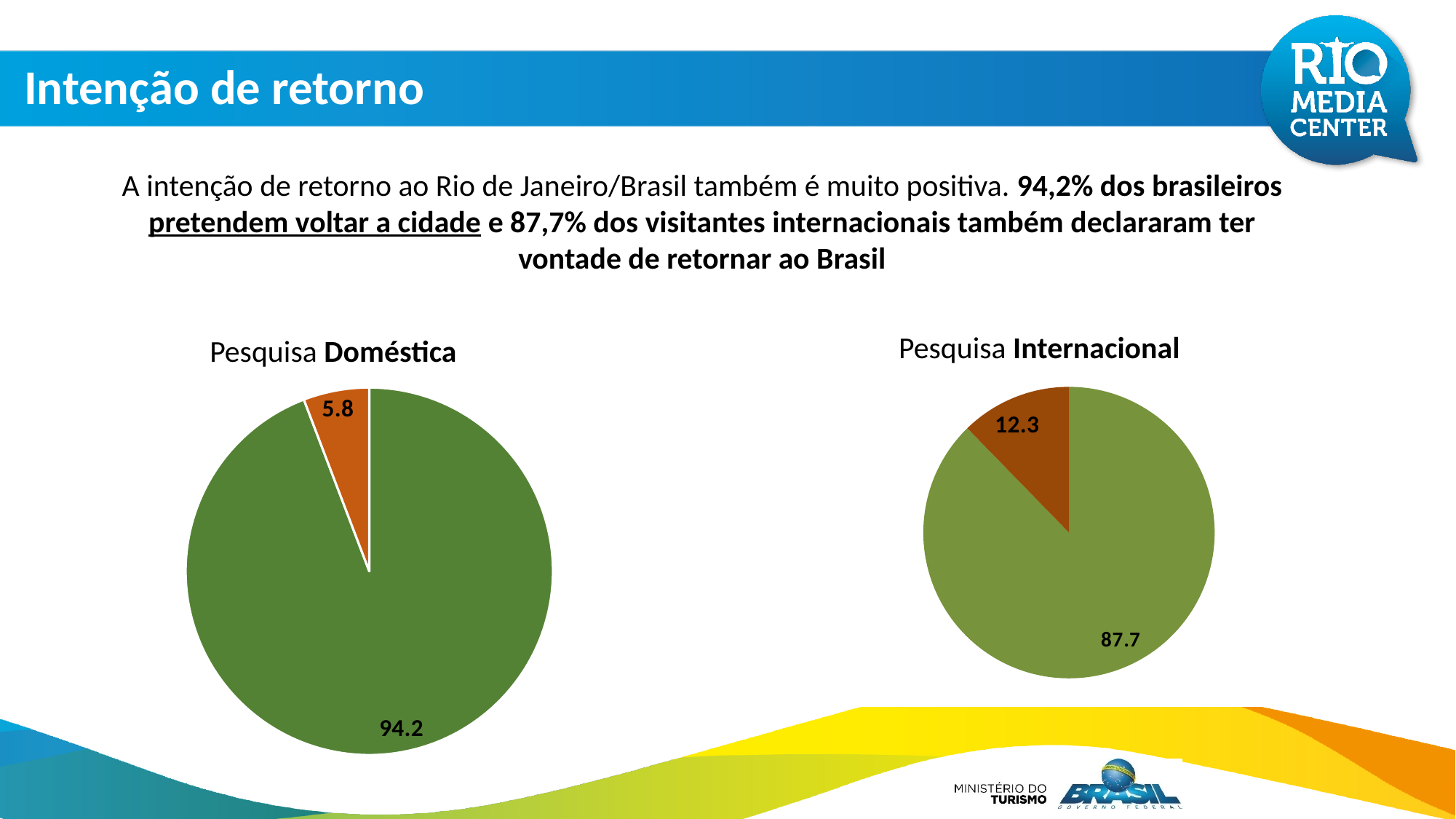
In the Pesquisa Doméstica chart, what value is shown on the small orange slice? 5.8 How many slices does the Pesquisa Doméstica pie chart have? 2 In the Pesquisa Internacional chart, what value is shown on the large green slice? 87.7 How many slices does the Pesquisa Internacional pie chart have? 2 In the Pesquisa Internacional chart, what is the difference between the two slice values? 75.4 In the Pesquisa Internacional chart, what value is shown on the brown slice? 12.3 In the Pesquisa Doméstica chart, what value is shown on the large green slice? 94.2 Which chart has the larger green slice, Pesquisa Doméstica or Pesquisa Internacional? Pesquisa Doméstica In the Pesquisa Doméstica chart, what is the difference between the two slice values? 88.4 Which chart has the larger small slice, Pesquisa Doméstica or Pesquisa Internacional? Pesquisa Internacional How many pie charts are shown on the slide? 2 What type of chart is used for Pesquisa Doméstica? pie chart